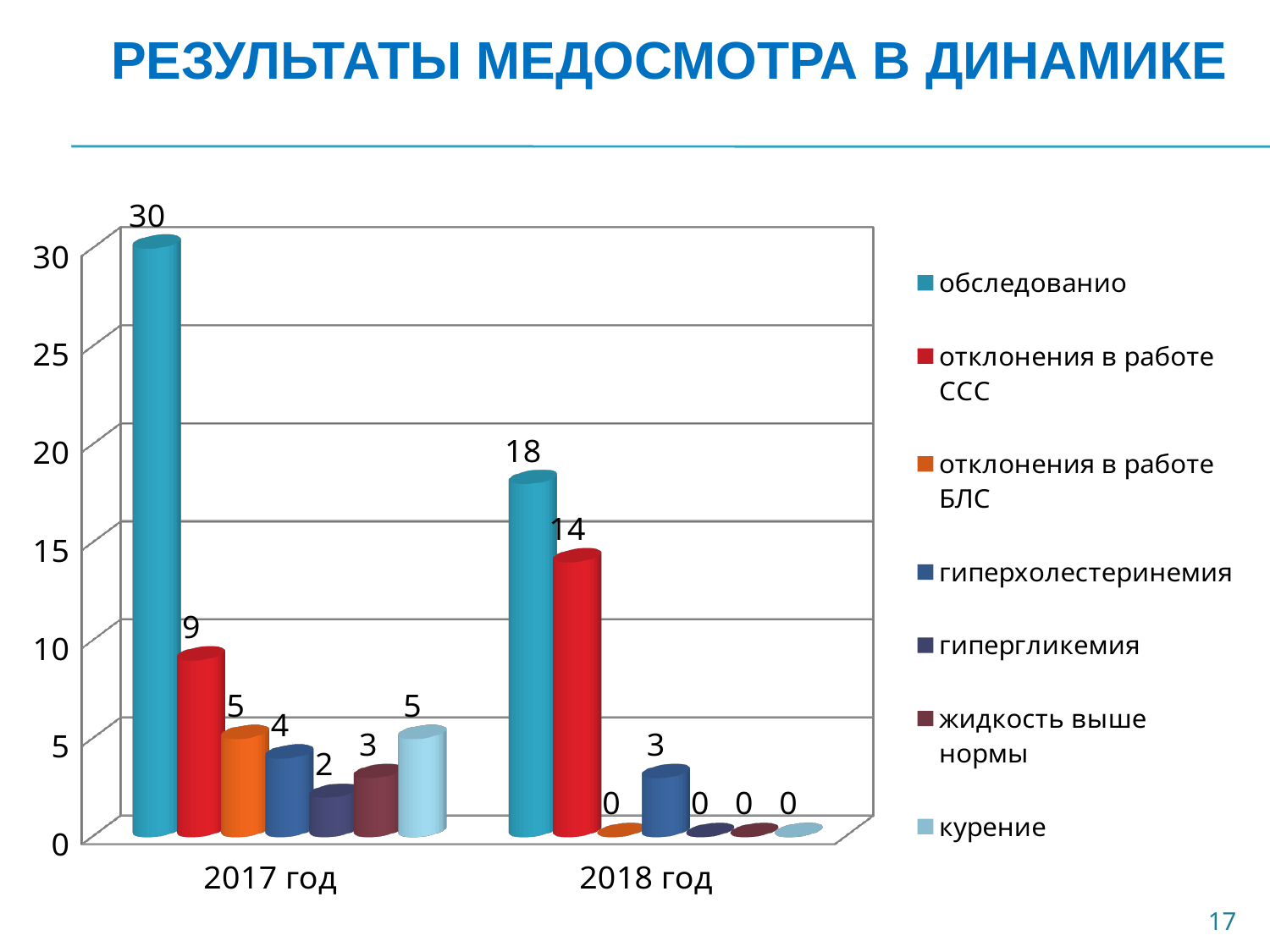
How many series does the legend list? 7 What kind of chart is shown on the slide? bar chart What is the title of the slide? РЕЗУЛЬТАТЫ МЕДОСМОТРА В ДИНАМИКЕ What is the value for гиперхолестеринемия in 2018 год? 3 What is the value for обследованио in 2017 год? 30 Which is larger: отклонения в работе ССС in 2017 год or in 2018 год? 2018 год Which series has the lowest value in 2017 год? гипергликемия What is the difference between the обследованио values for 2017 год and 2018 год? 12 What is the value for курение in 2017 год? 5 What is the value for отклонения в работе ССС in 2018 год? 14 How many categories are shown on the x axis? 2 Which series has the highest value in 2017 год? обследованио